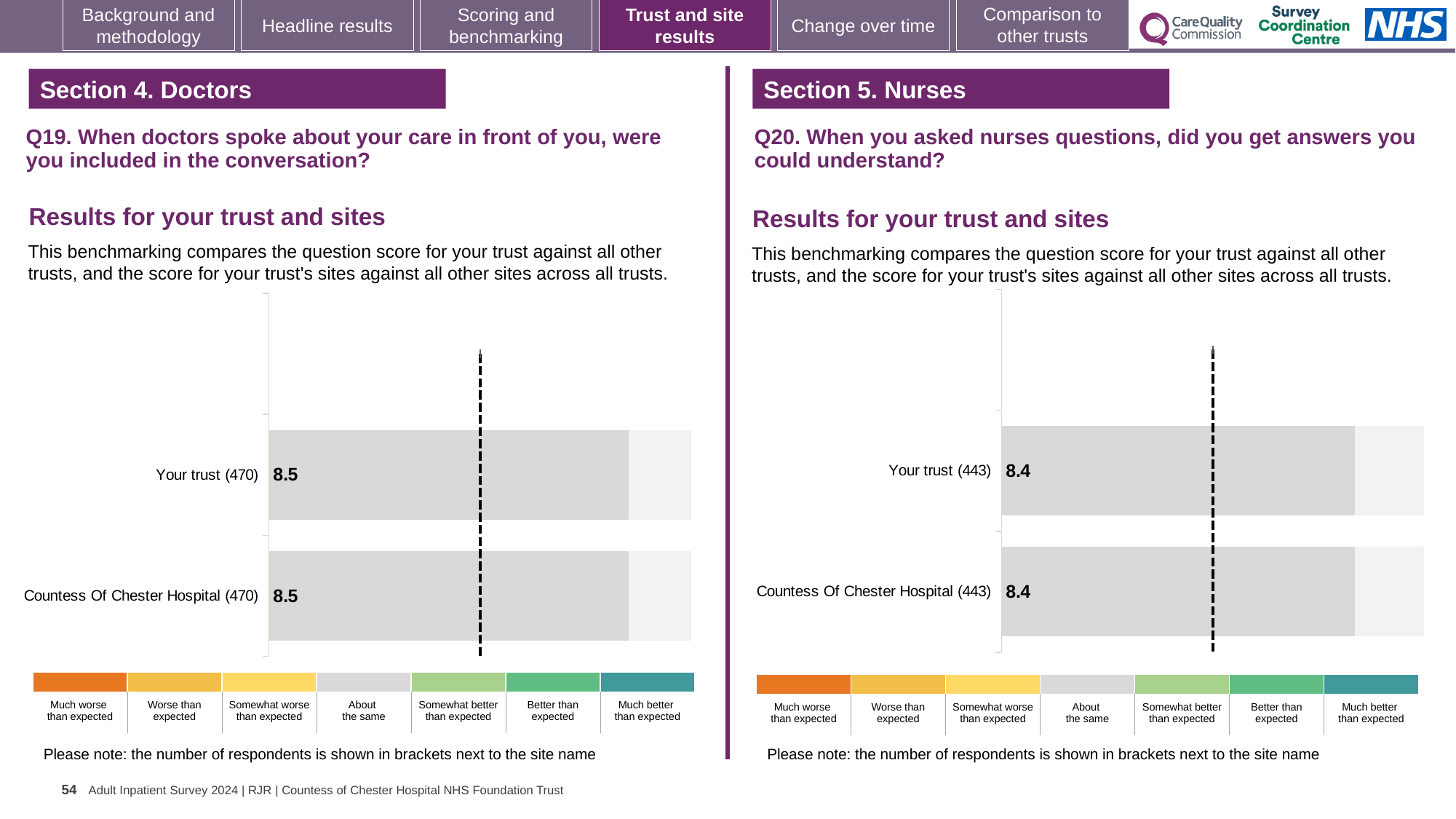
In the Q19 chart on the left, what is the score for Your trust? 8.5 How many bars are plotted in the Q20 chart on the right? 2 Is the score for Your trust in the Q20 chart on the right larger or smaller than the score for Your trust in the Q19 chart on the left? Smaller In the Q20 chart on the right, what is the difference between the score for Your trust and the score for Countess Of Chester Hospital? 0 In the Q19 chart on the left, what is the difference between the score for Your trust and the score for Countess Of Chester Hospital? 0 In the Q19 chart on the left, what is the score for Countess Of Chester Hospital? 8.5 In the Q20 chart on the right, how many respondents are shown in brackets for Countess Of Chester Hospital? 443 In the Q19 chart on the left, how many respondents are shown in brackets for Your trust? 470 How many bars are plotted in the Q19 chart on the left? 2 In the Q20 chart on the right, what is the score for Your trust? 8.4 What type of chart is used in the Q19 chart on the left? Bar chart In the Q20 chart on the right, what is the score for Countess Of Chester Hospital? 8.4